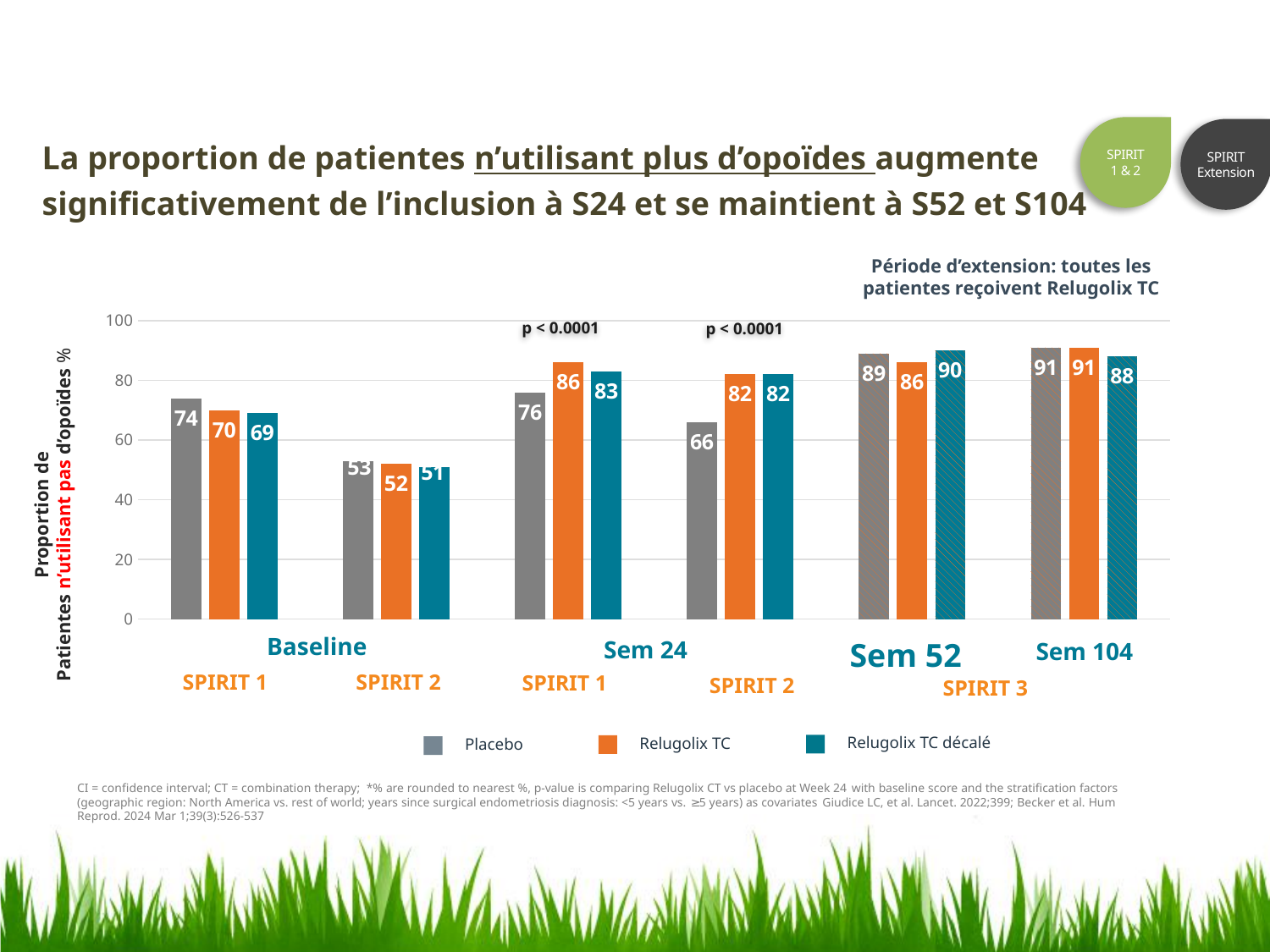
What is the label of the y axis? Proportion de Patientes n'utilisant pas d'opoïdes % What is the Relugolix TC value at Baseline for SPIRIT 2? 52 What is the Relugolix TC value at Sem 24 for SPIRIT 2? 82 What kind of chart is shown on the slide? Bar chart What is the difference between the Relugolix TC and Placebo values at Sem 24 for SPIRIT 2? 16 Is the Placebo value at Sem 24 for SPIRIT 2 greater or less than 80? less What is the Placebo value at Baseline for SPIRIT 1? 74 What is the difference between the Relugolix TC and Placebo values at Sem 24 for SPIRIT 1? 10 How many series does the legend list? 3 Which group of bars has the lowest values on the chart? Baseline SPIRIT 2 At Sem 24 for SPIRIT 1, which is larger: the Placebo value or the Relugolix TC value? Relugolix TC What is the Relugolix TC décalé value at Sem 52 (SPIRIT 3)? 90